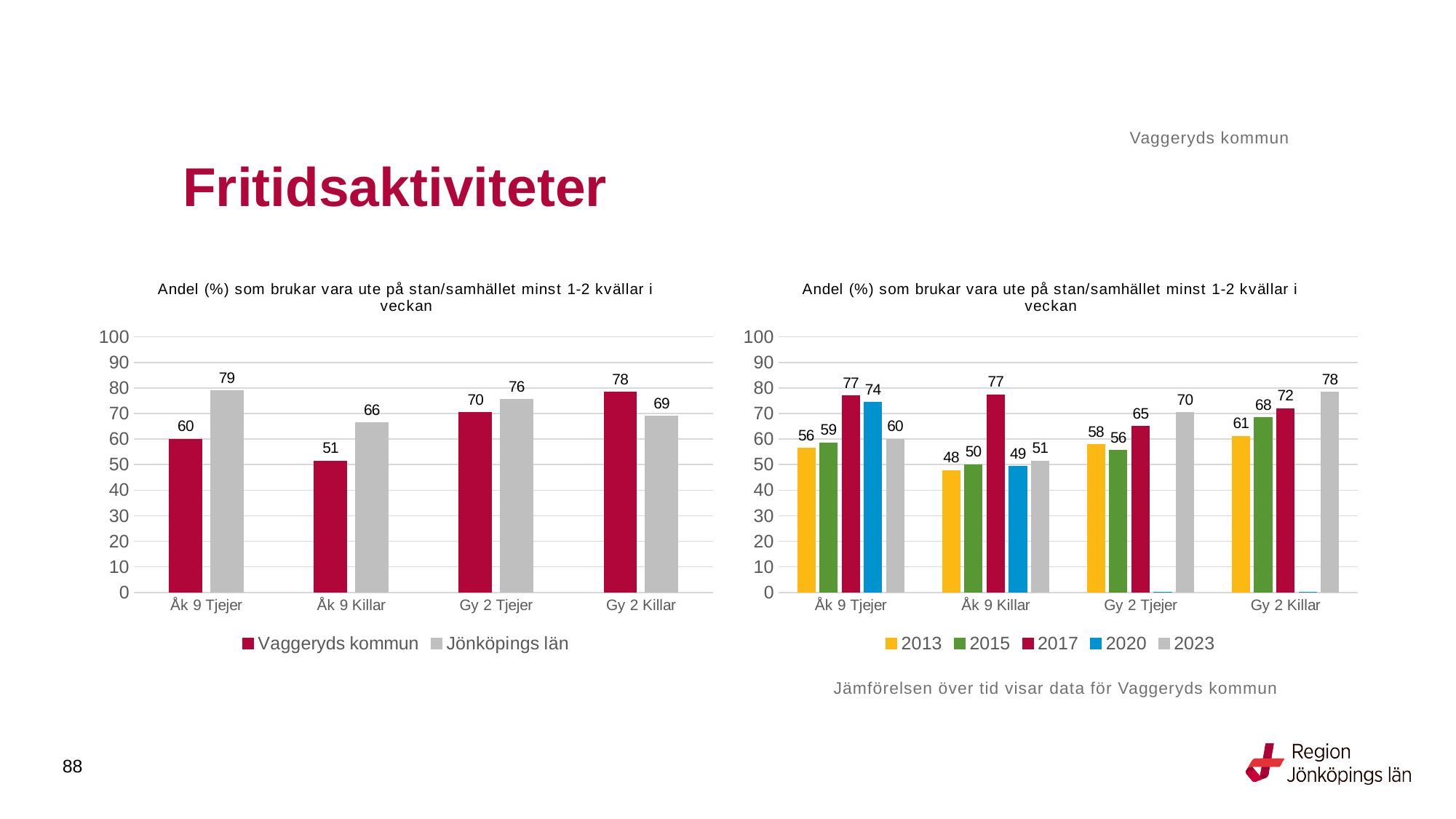
In the right chart, which year has the highest value for Gy 2 Killar? 2023 In the left chart, which category has the lowest value for Vaggeryds kommun? Åk 9 Killar In the right chart, what is the value for 2017 for Åk 9 Killar? 77 In the left chart, what is the value for Jönköpings län for Gy 2 Tjejer? 76 In the left chart, what is the value for Vaggeryds kommun for Åk 9 Tjejer? 60 How many series does the legend of the left chart list? 2 In the left chart, what is the difference between Jönköpings län and Vaggeryds kommun for Åk 9 Tjejer? 19 What type of chart is the right chart? Bar chart In the right chart, what is the value for 2020 for Åk 9 Tjejer? 74 How many series does the legend of the right chart list? 5 In the right chart, what is the difference between 2013 and 2023 for Gy 2 Tjejer? 12 In the left chart, which is larger for Gy 2 Killar: Vaggeryds kommun or Jönköpings län? Vaggeryds kommun